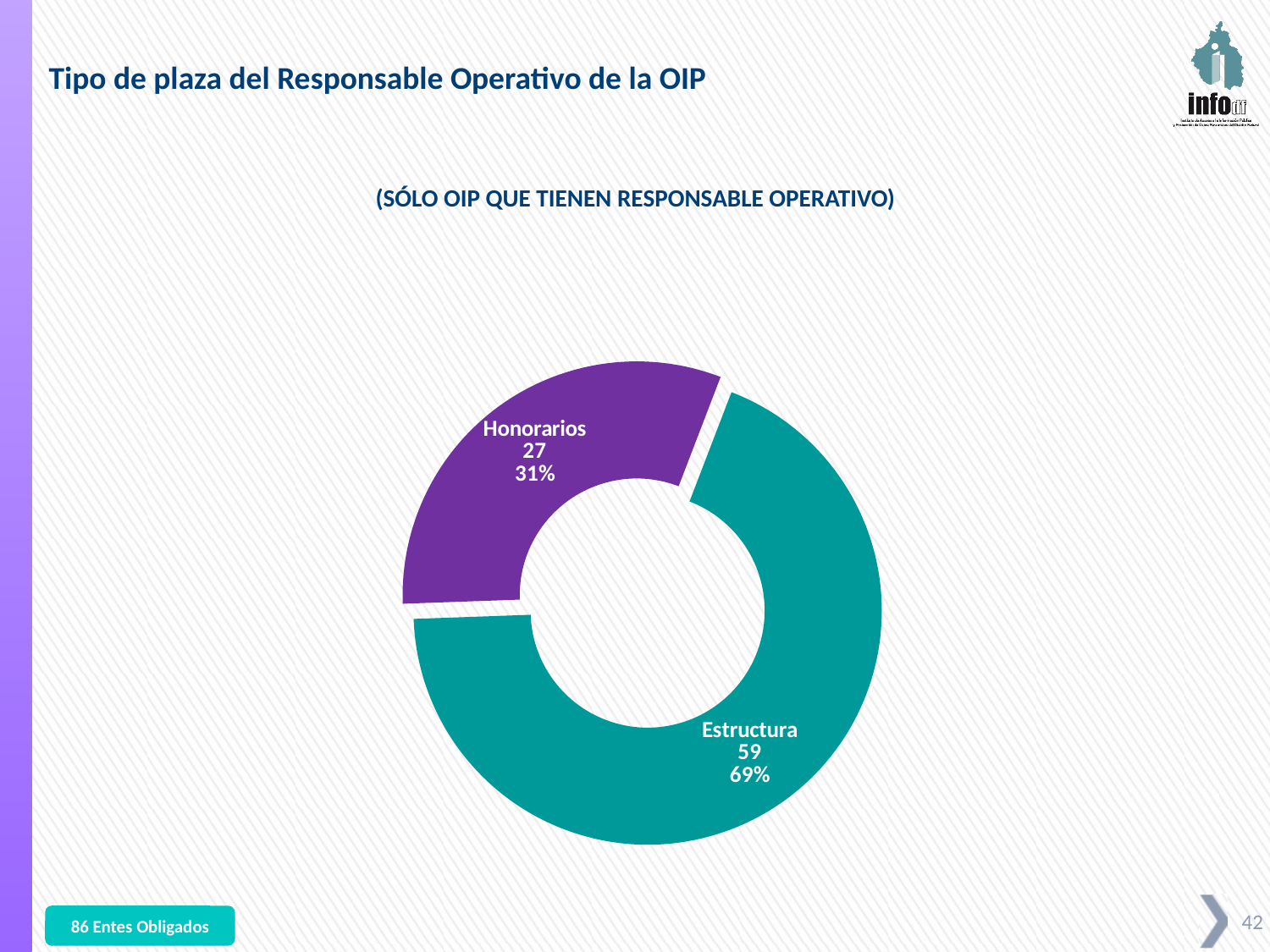
What share of the pie does Honorarios represent? 31% What is the value for Estructura? 59 Which category has the highest value? Estructura What share of the pie does Estructura represent? 69% What colour is the Honorarios slice? Purple What is the total of the two values shown in the chart? 86 What is the difference between the values for Estructura and Honorarios? 32 How many categories does the chart show? 2 What kind of chart is shown on the slide? Pie chart (doughnut) What is the value for Honorarios? 27 Which is larger, Estructura or Honorarios? Estructura Which category has the lowest value? Honorarios